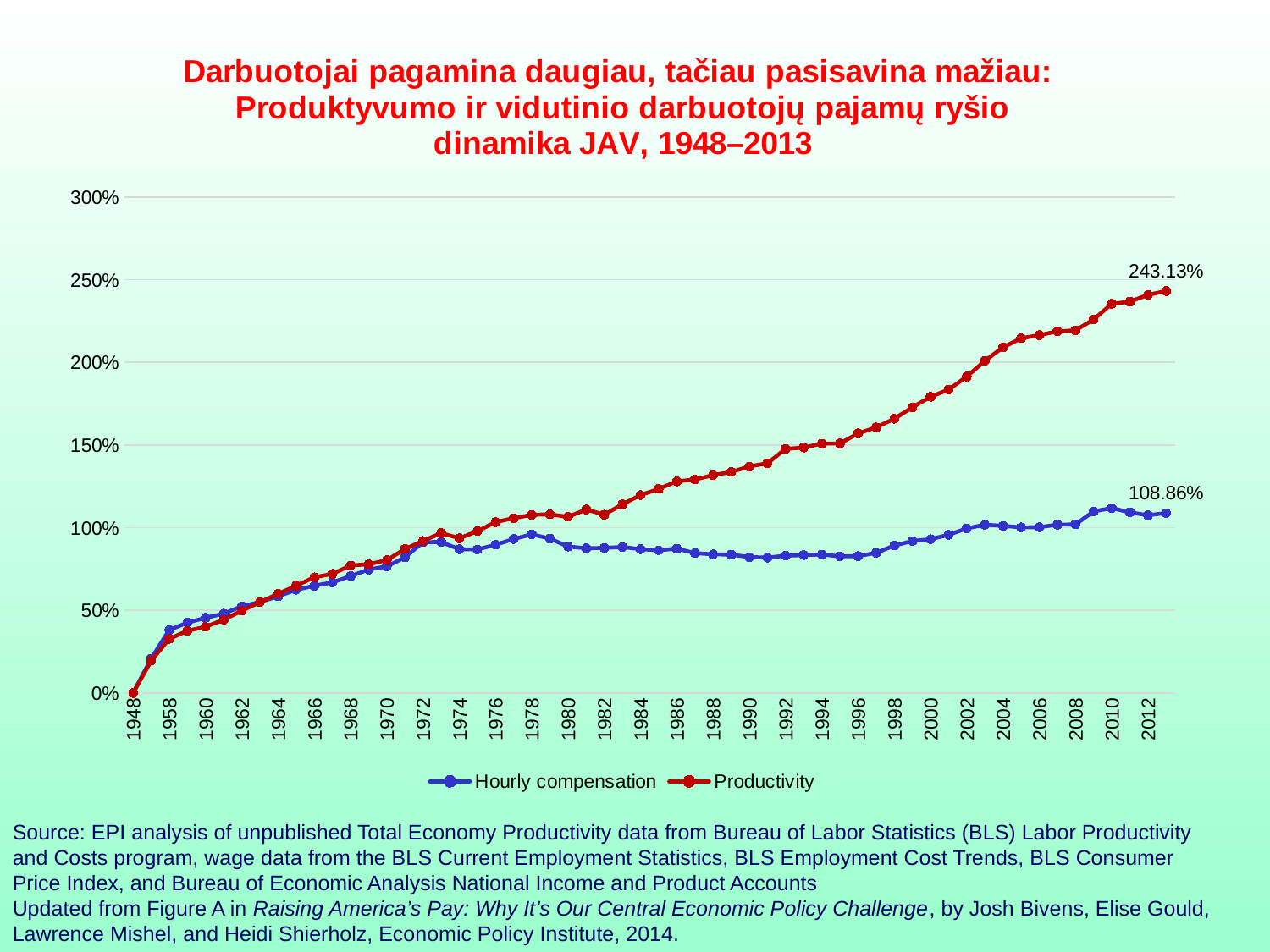
What colour is the Productivity line in the chart? Red What is the difference between the final Productivity value and the final Hourly compensation value? 134.27% Which series has the higher value in 2013, Productivity or Hourly compensation? Productivity Does the Productivity series rise or fall from 1948 to 2013? Rises Is the Hourly compensation value for 1990 greater or less than 100%? less Is the Productivity value for 1984 greater or less than 100%? greater How many series does the legend list? 2 What kind of chart is shown on the slide? Line chart What value do both series start at in 1948? 0% Is the Productivity value for 2000 greater or less than 150%? greater What is the value of the Productivity series at the end of the chart (2013)? 243.13% What is the value of the Hourly compensation series at the end of the chart (2013)? 108.86%